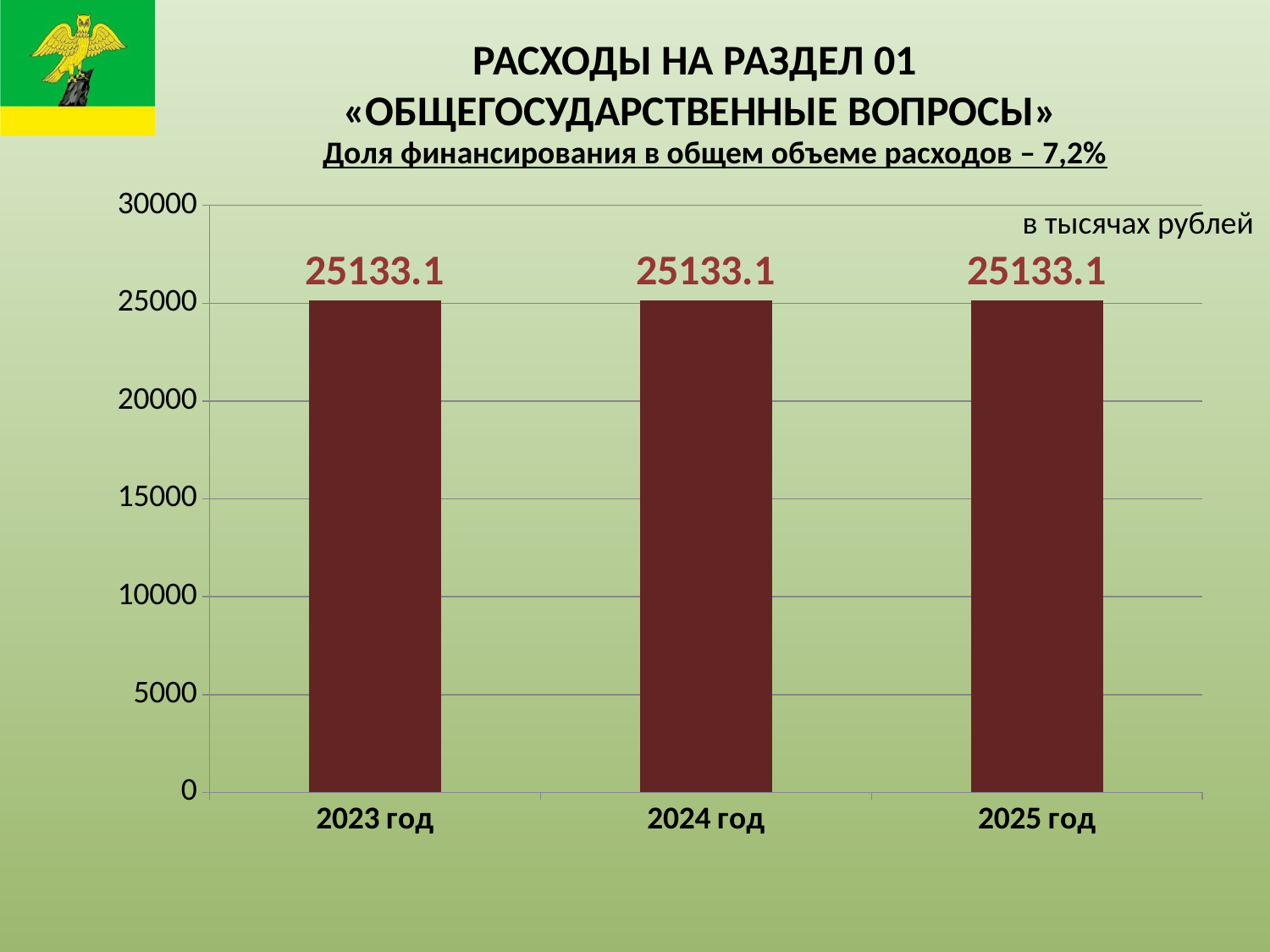
What is the difference between the values for 2023 год and 2025 год? 0 Is the value for 2023 год greater or less than 30000? less Do the values rise, fall or stay the same from 2023 год to 2025 год? stay the same How many categories are shown on the x axis? 3 What kind of chart is shown on the slide? bar chart What unit is stated for the values on the chart? в тысячах рублей Is the value for 2024 год greater or less than 25000? greater What is the value for 2023 год? 25133.1 What share of total expenditure does the subtitle give for this section? 7,2% What is the value for 2024 год? 25133.1 What is the value for 2025 год? 25133.1